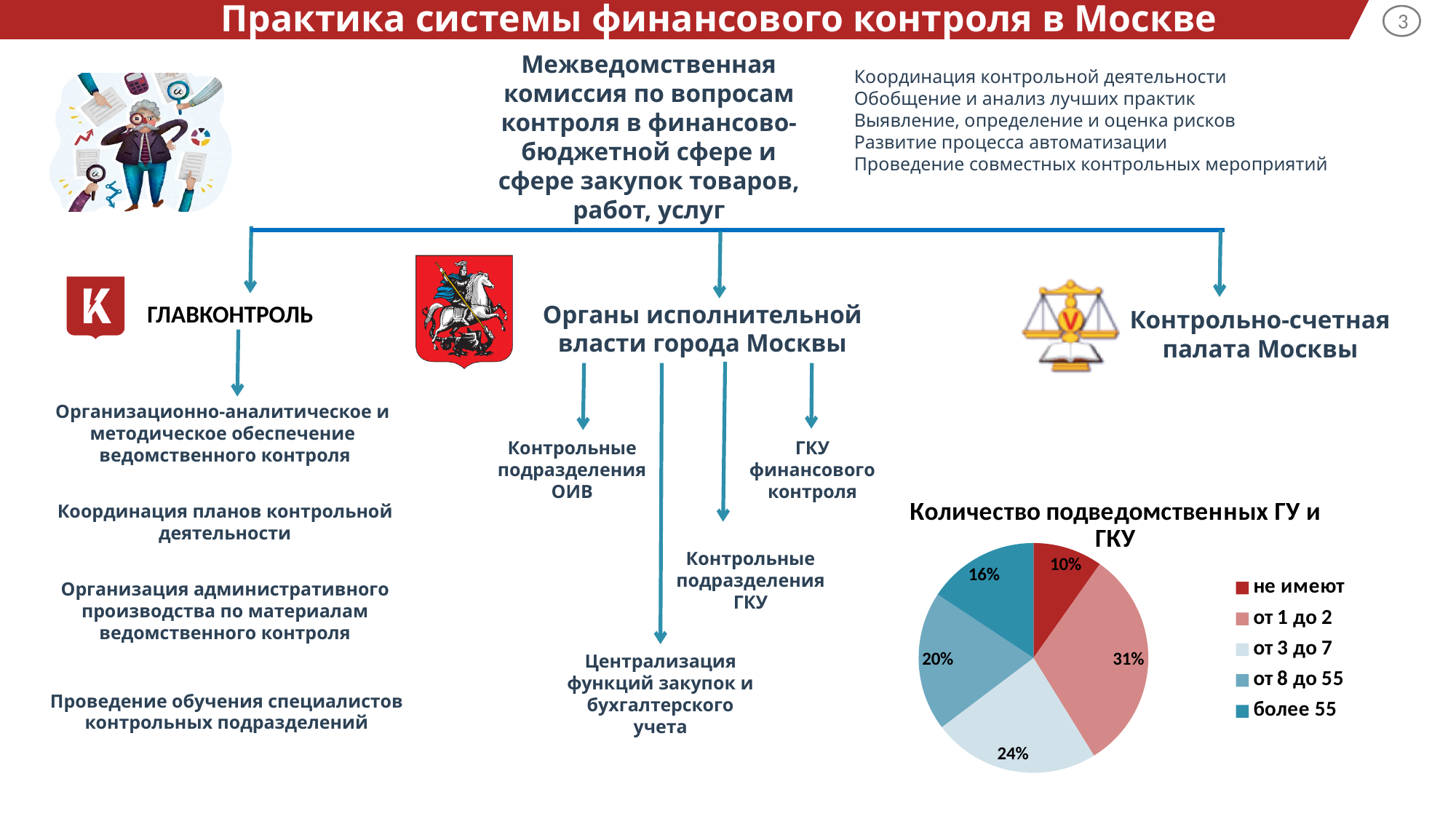
Which category has the smallest slice in the pie chart? не имеют What is the title of the pie chart? Количество подведомственных ГУ и ГКУ What is the difference between the 'от 1 до 2' and 'от 8 до 55' slices? 11% Which category has the largest slice in the pie chart? от 1 до 2 What is the value shown for 'от 3 до 7' in the pie chart? 24% What is the value shown for 'не имеют' in the pie chart? 10% Which is larger in the pie chart: 'от 3 до 7' or 'более 55'? от 3 до 7 What share of the pie does the 'от 1 до 2' slice have? 31% How many entries does the legend of the pie chart list? 5 What kind of chart is shown on the slide? pie chart What is the value shown for 'более 55' in the pie chart? 16% How many slices does the pie chart have? 5